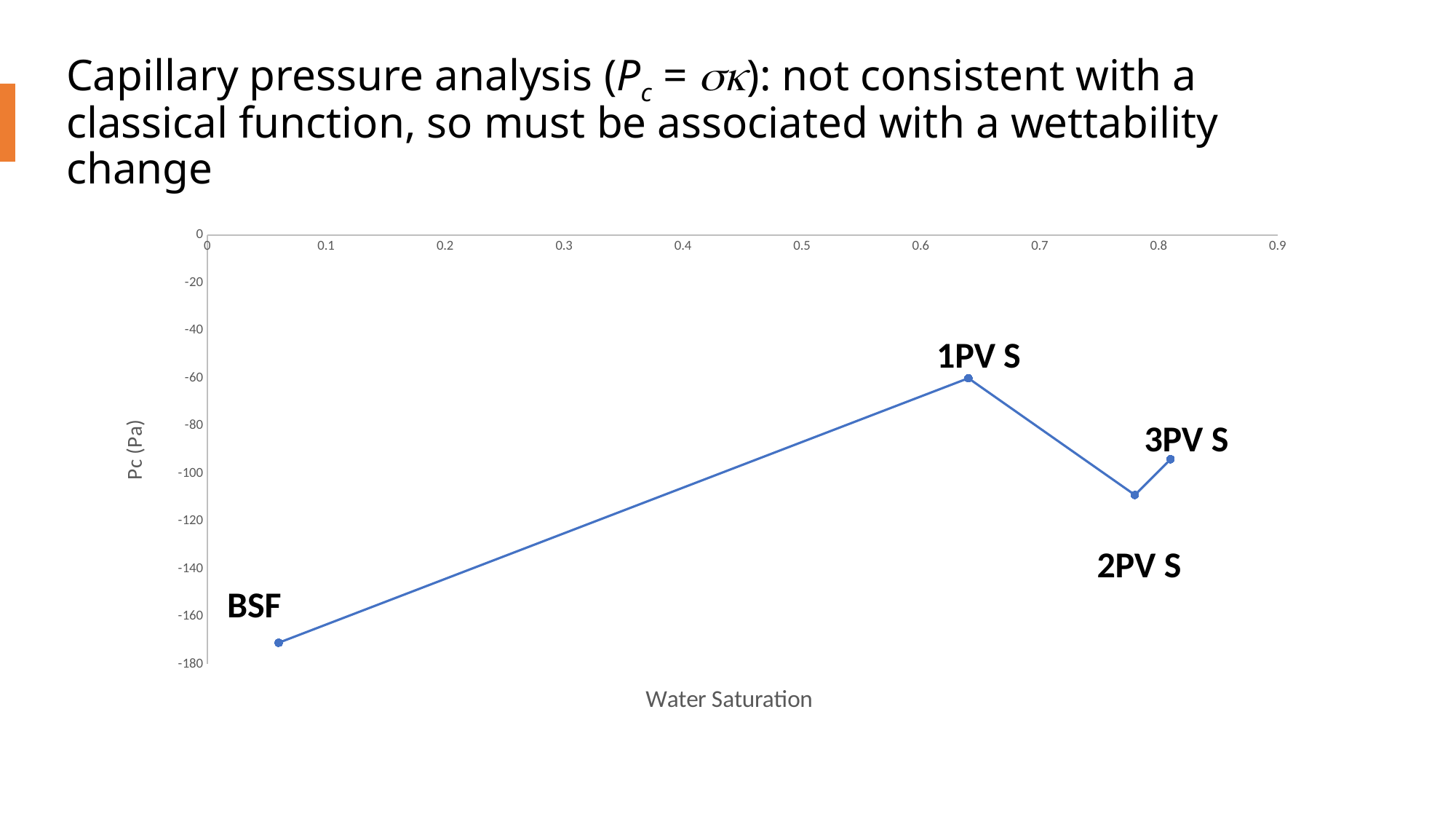
How many labelled data points are plotted on the chart? 4 Is the Pc value for BSF greater or less than -160? less Which has the higher water saturation, BSF or 1PV S? 1PV S Is the Pc value for 2PV S greater or less than -100? less Does the Pc value rise or fall from BSF to 1PV S? rise Which labelled point has the lowest (most negative) Pc value? BSF What is the title of the x axis? Water Saturation What kind of chart is shown on the slide? line chart Which labelled point has the highest (least negative) Pc value? 1PV S Which has the higher Pc value, 2PV S or 3PV S? 3PV S Is the water saturation for BSF greater or less than 0.1? less